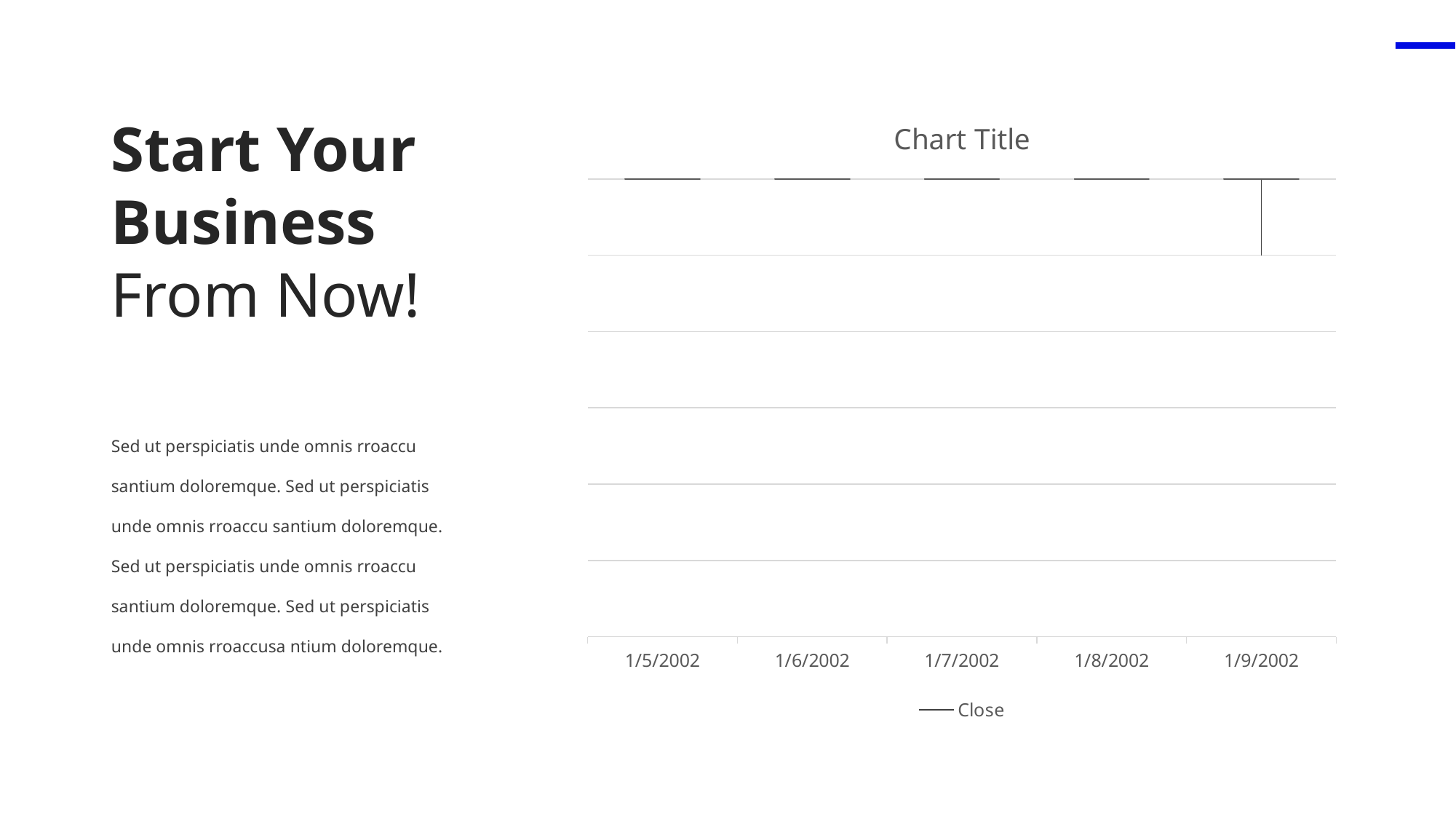
How many dates are shown on the x axis of the chart? 5 What is the title of the chart? Chart Title What is the last date shown on the x axis of the chart? 1/9/2002 What is the name of the series shown in the chart's legend? Close Which date label appears in the middle of the chart's x axis? 1/7/2002 How many series does the chart's legend list? 1 What is the first date shown on the x axis of the chart? 1/5/2002